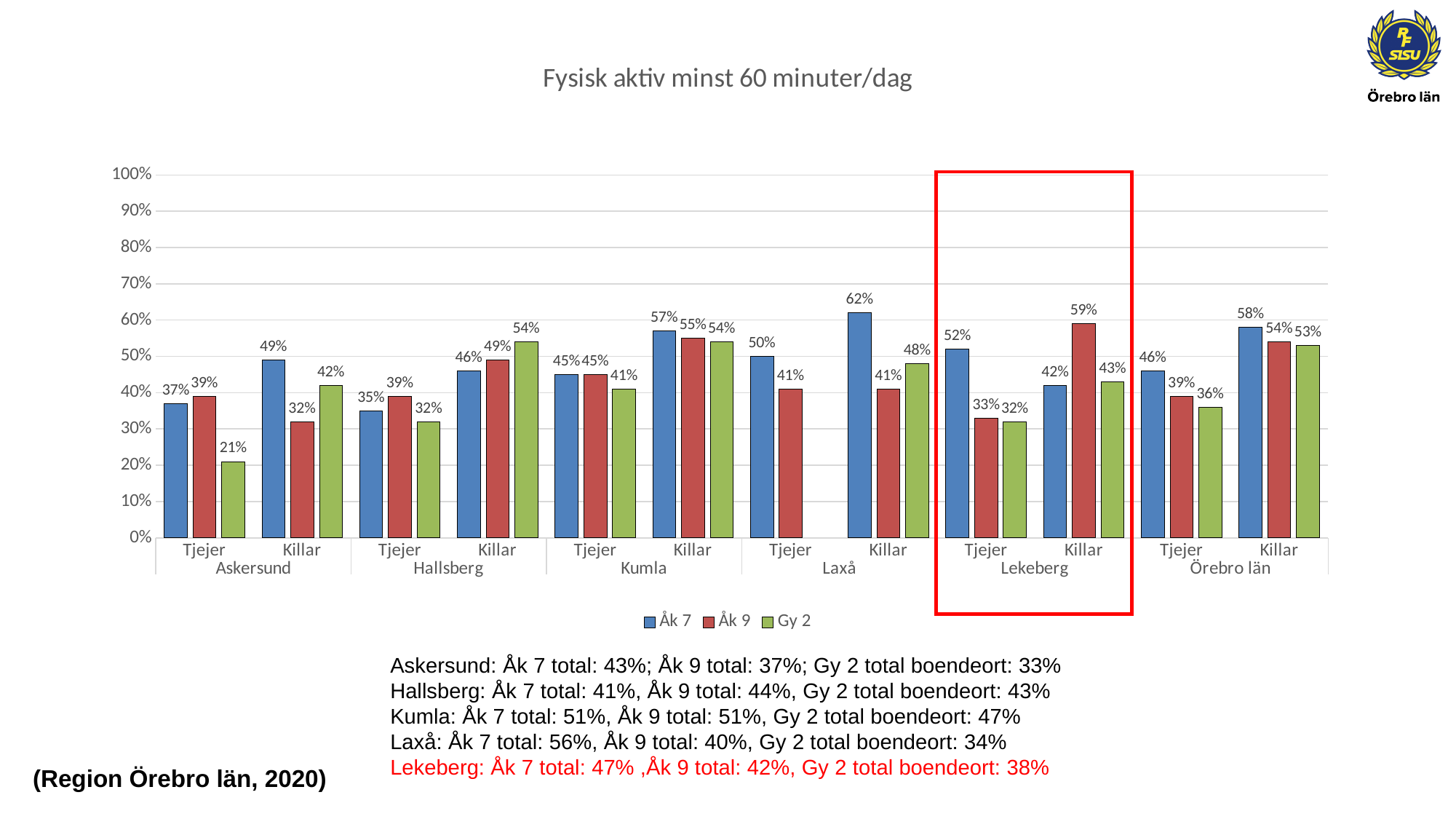
What is the title of the chart? Fysisk aktiv minst 60 minuter/dag What is the difference between the Åk 7 value for Tjejer in Lekeberg and the Åk 9 value for Tjejer in Lekeberg? 19 percentage points What is the Gy 2 value for Tjejer in Askersund? 21% Is the Åk 7 value for Killar in Örebro län greater or less than 50%? greater How many series does the legend list? 3 What is the Åk 9 value for Killar in Lekeberg? 59% Which group and series has the lowest value in the chart? Tjejer in Askersund, Gy 2 (21%) What is the Åk 7 value for Tjejer in Örebro län? 46% Which is larger: the Gy 2 value for Killar in Hallsberg or the Gy 2 value for Killar in Kumla? Neither; they are equal (both 54%) Which group and series has the highest value in the chart? Killar in Laxå, Åk 7 (62%) What kind of chart is shown on the slide? Bar chart What is the Åk 7 value for Killar in Laxå? 62%